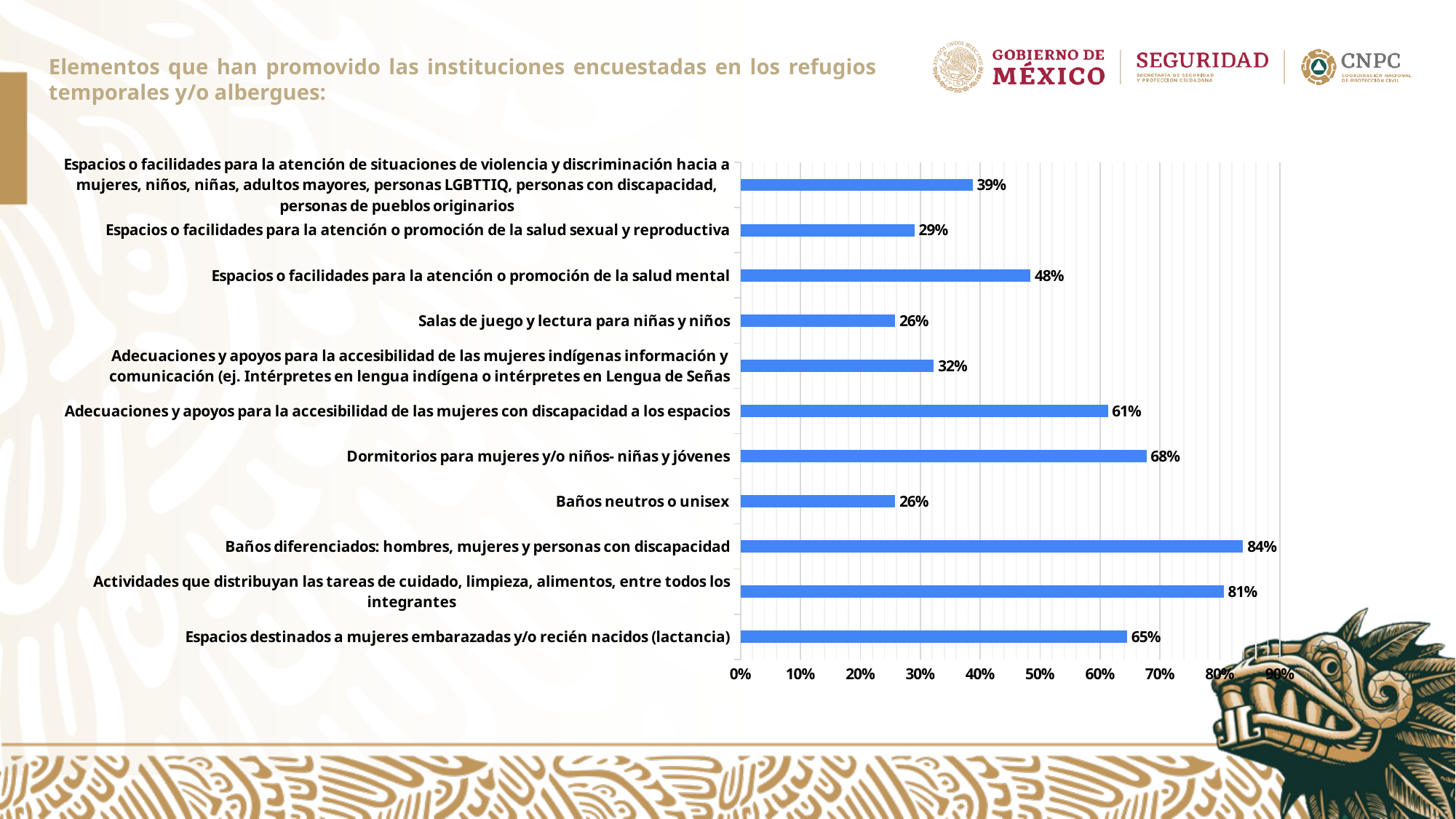
How many categories are plotted in the chart? 11 What value is shown for "Espacios destinados a mujeres embarazadas y/o recién nacidos (lactancia)"? 65% Which is larger: the value for "Espacios o facilidades para la atención o promoción de la salud sexual y reproductiva" or the value for "Adecuaciones y apoyos para la accesibilidad de las mujeres indígenas información y comunicación"? Adecuaciones y apoyos para la accesibilidad de las mujeres indígenas información y comunicación What is the title of the chart on the slide? Elementos que han promovido las instituciones encuestadas en los refugios temporales y/o albergues: What kind of chart is shown on the slide? Bar chart What is the difference between the values for "Baños diferenciados: hombres, mujeres y personas con discapacidad" and "Actividades que distribuyan las tareas de cuidado, limpieza, alimentos, entre todos los integrantes"? 3% What value is shown for "Dormitorios para mujeres y/o niños- niñas y jóvenes"? 68% What value is shown for "Baños diferenciados: hombres, mujeres y personas con discapacidad"? 84% What value is shown for "Espacios o facilidades para la atención o promoción de la salud mental"? 48% Which category has the highest value in the chart? Baños diferenciados: hombres, mujeres y personas con discapacidad What is the difference between the values for "Adecuaciones y apoyos para la accesibilidad de las mujeres con discapacidad a los espacios" and "Salas de juego y lectura para niñas y niños"? 35% What is the lowest value shown in the chart? 26%